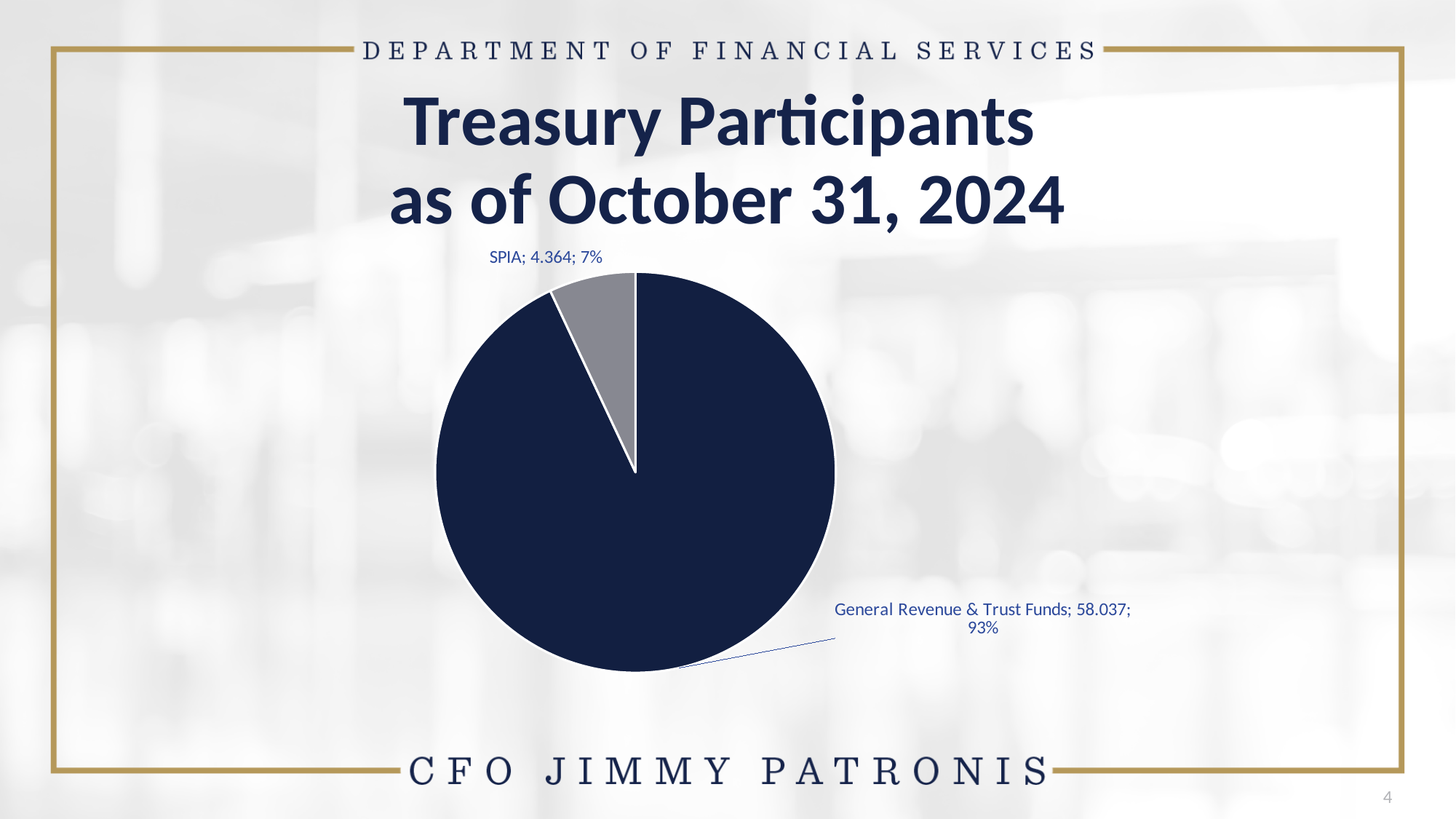
What is the value for General Revenue & Trust Funds? 58.037 How many categories are shown in the pie chart? 2 What share of the pie does General Revenue & Trust Funds represent? 93% What is the title of the slide containing the chart? Treasury Participants as of October 31, 2024 What type of chart is shown on the slide? pie chart Which category has the smallest slice of the pie? SPIA Which is larger, the value for SPIA or the value for General Revenue & Trust Funds? General Revenue & Trust Funds What is the difference between the values for General Revenue & Trust Funds and SPIA? 53.673 What colour is the SPIA slice of the pie? grey Which category has the largest slice of the pie? General Revenue & Trust Funds What share of the pie does SPIA represent? 7% What is the value for SPIA? 4.364